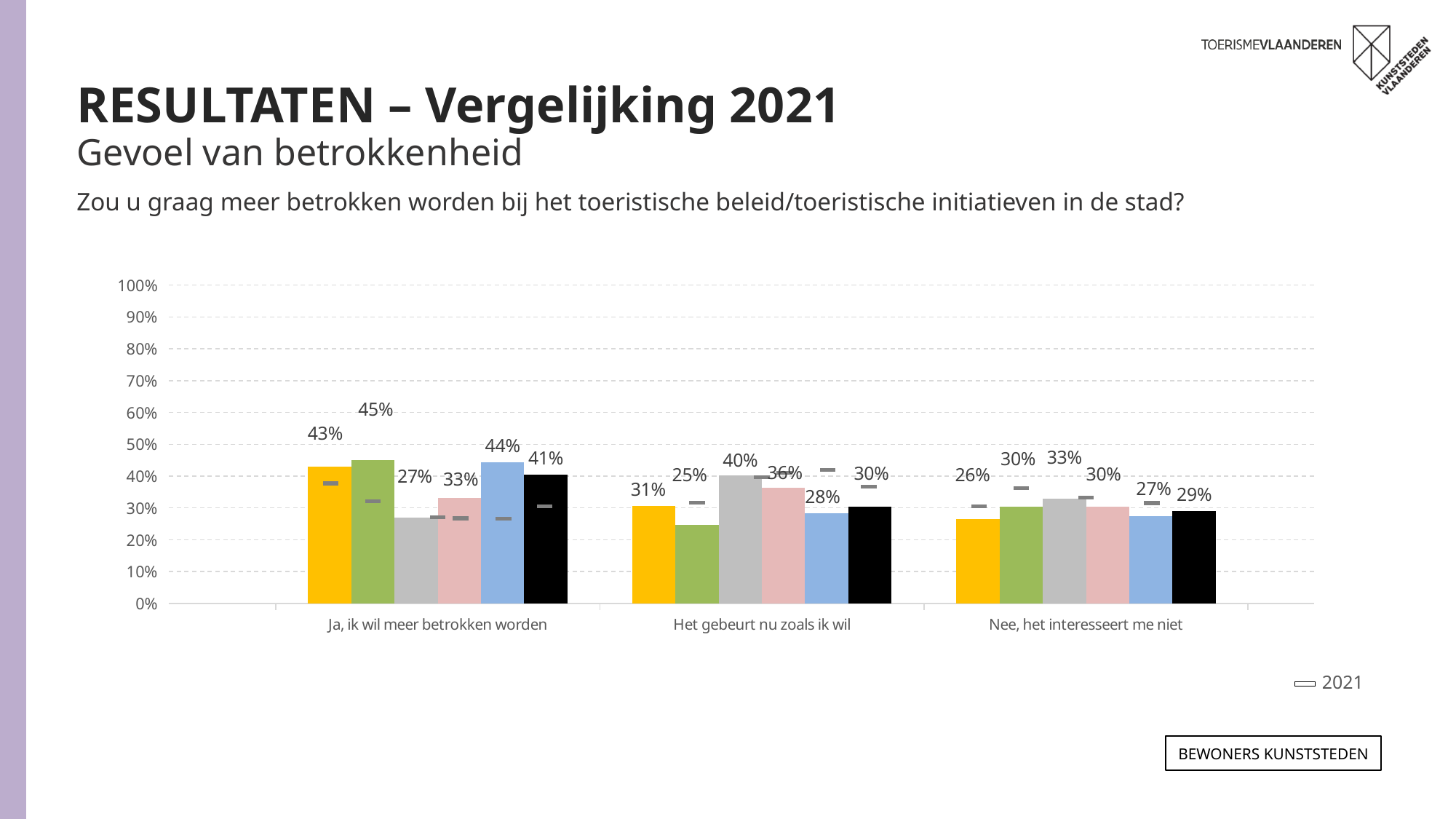
What is the highest value labelled in the 'Ja, ik wil meer betrokken worden' group? 45% What is the difference between the yellow bar for 'Ja, ik wil meer betrokken worden' (43%) and the yellow bar for 'Nee, het interesseert me niet' (26%)? 17 percentage points What kind of chart is shown on the slide? bar chart Is the grey bar larger for 'Het gebeurt nu zoals ik wil' or for 'Nee, het interesseert me niet'? Het gebeurt nu zoals ik wil What is the value of the black bar for 'Het gebeurt nu zoals ik wil'? 30% What is the value of the blue bar for 'Nee, het interesseert me niet'? 27% What is the lowest value labelled in the 'Het gebeurt nu zoals ik wil' group? 25% How many categories are shown on the x axis of the chart? 3 What is the value of the yellow bar for 'Ja, ik wil meer betrokken worden'? 43% What is the only entry shown in the chart legend? 2021 What is the label of the third category on the x axis? Nee, het interesseert me niet Is the value of the green bar for 'Ja, ik wil meer betrokken worden' greater or less than 50%? less